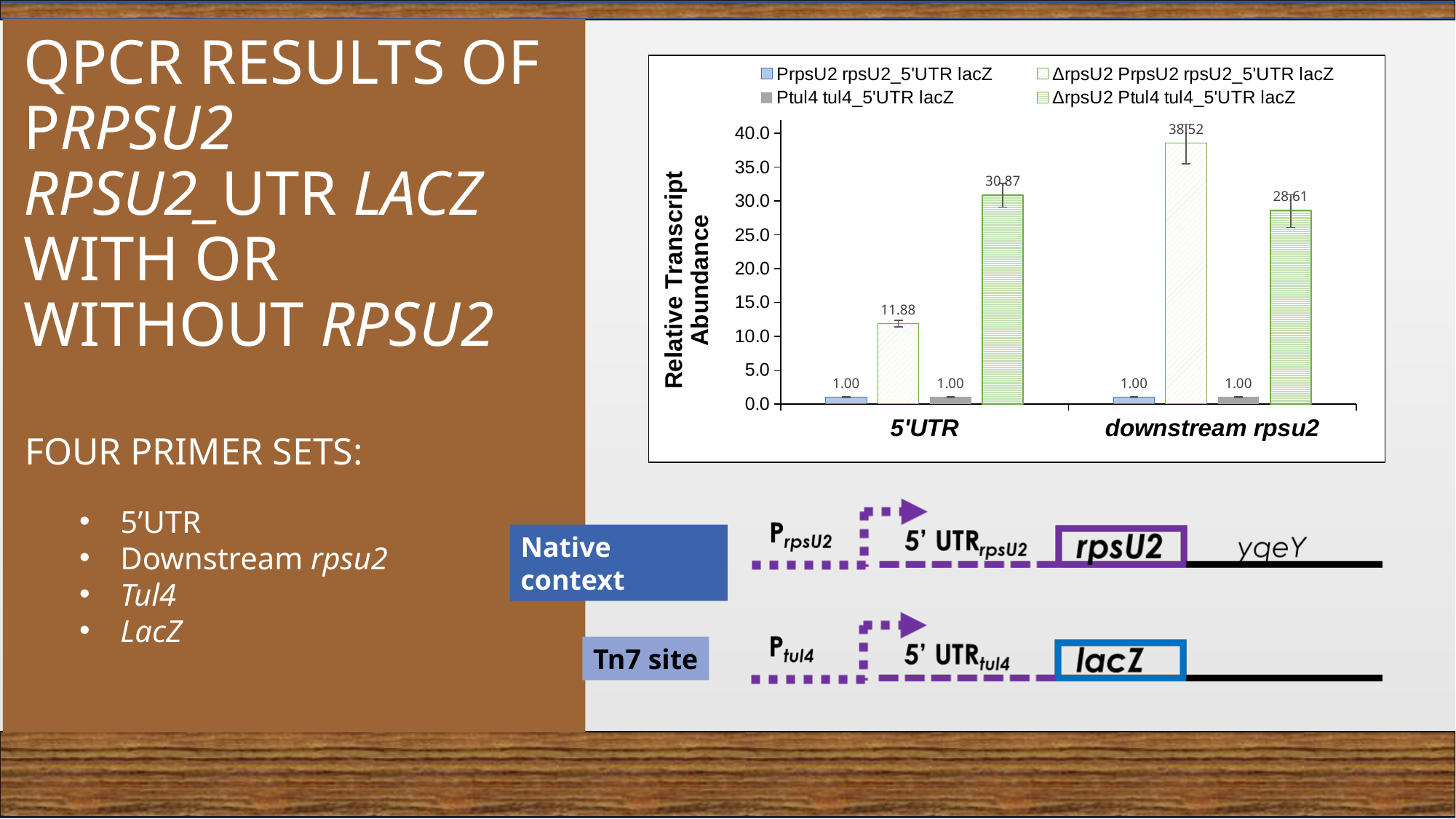
What is the value of PrpsU2 rpsU2_5'UTR lacZ for the 5'UTR category? 1.00 What is the value of ΔrpsU2 Ptul4 tul4_5'UTR lacZ for the downstream rpsu2 category? 28.61 How many categories are shown on the x axis? 2 Which series has the highest value in the 5'UTR category? ΔrpsU2 Ptul4 tul4_5'UTR lacZ Which series has the highest value in the downstream rpsu2 category? ΔrpsU2 PrpsU2 rpsU2_5'UTR lacZ What is the label of the y axis? Relative Transcript Abundance What is the value of ΔrpsU2 PrpsU2 rpsU2_5'UTR lacZ for the downstream rpsu2 category? 38.52 What is the difference between the ΔrpsU2 PrpsU2 rpsU2_5'UTR lacZ values for downstream rpsu2 and 5'UTR? 26.64 What is the value of ΔrpsU2 PrpsU2 rpsU2_5'UTR lacZ for the 5'UTR category? 11.88 How many series does the legend list? 4 Which is larger for ΔrpsU2 Ptul4 tul4_5'UTR lacZ: the 5'UTR value or the downstream rpsu2 value? 5'UTR What is the difference between ΔrpsU2 Ptul4 tul4_5'UTR lacZ and ΔrpsU2 PrpsU2 rpsU2_5'UTR lacZ in the 5'UTR category? 18.99